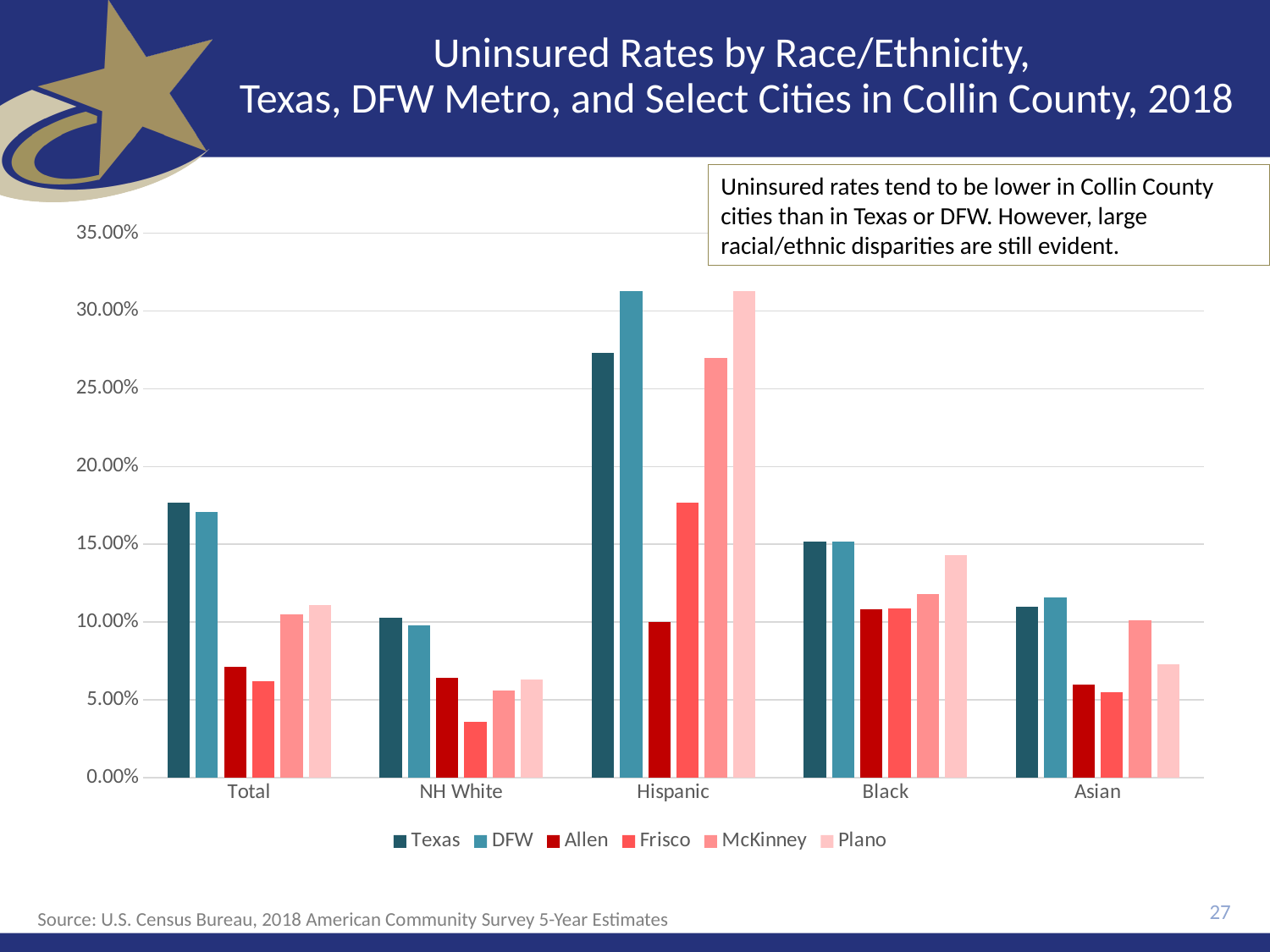
Is the value for Frisco in the NH White category greater or less than 5.00%? less In the Black category, which is larger, the value for Plano or the value for McKinney? Plano Is the value for Texas in the Hispanic category greater or less than 25.00%? greater In the Hispanic category, which is larger, the value for Frisco or the value for McKinney? McKinney Is the value for DFW in the Asian category greater or less than 10.00%? greater In the Hispanic category, which series has the lowest uninsured rate? Allen How many series does the legend list? 6 What kind of chart is shown on the slide? Bar chart How many race/ethnicity categories are shown on the x axis? 5 In the NH White category, which series has the lowest uninsured rate? Frisco What is the title of the chart? Uninsured Rates by Race/Ethnicity, Texas, DFW Metro, and Select Cities in Collin County, 2018